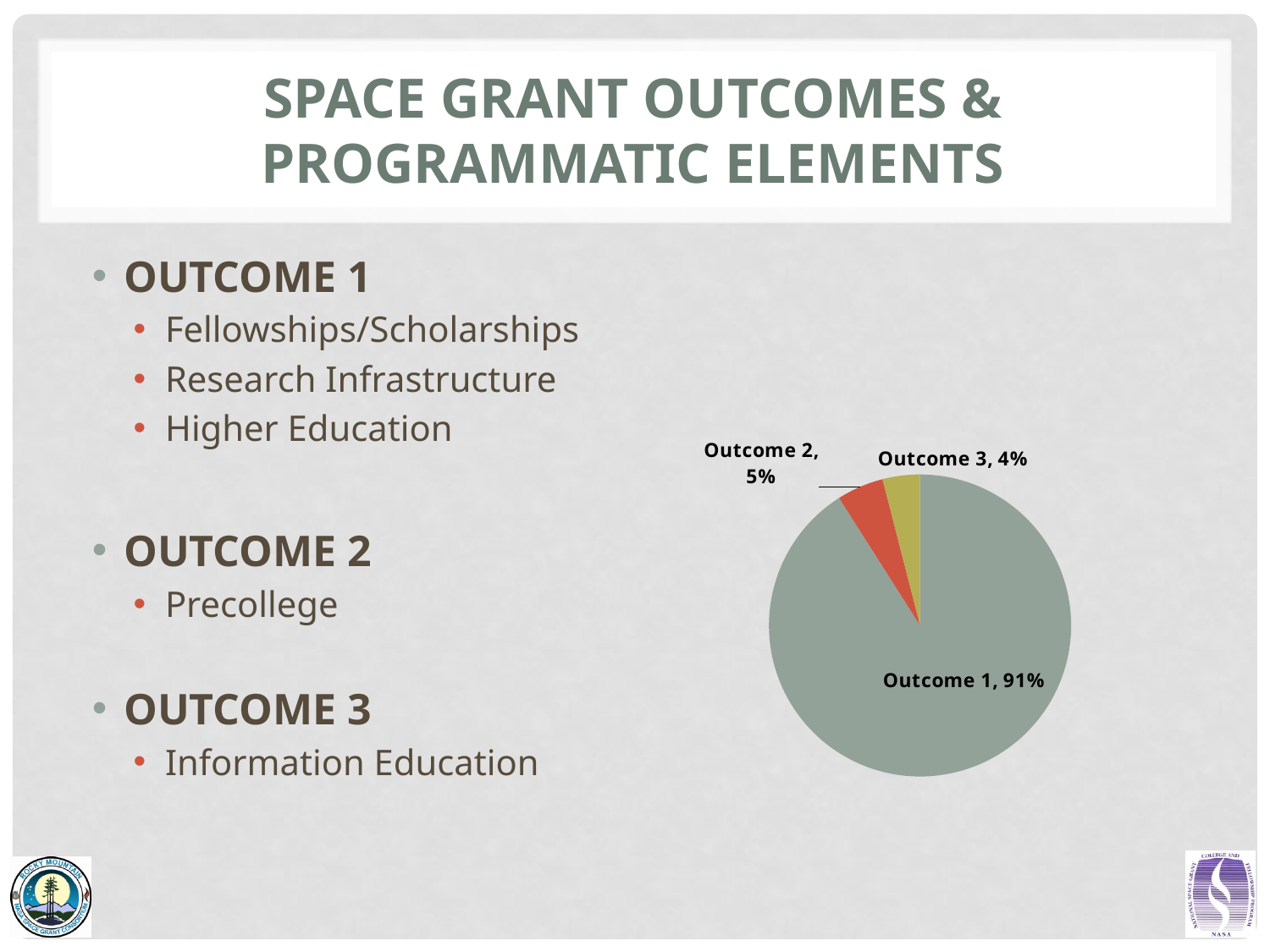
Which is larger, the slice for Outcome 2 or the slice for Outcome 3? Outcome 2 What colour is the slice for Outcome 1? grey-green How many slices does the pie chart have? 3 What is the difference in percentage points between Outcome 2 and Outcome 3? 1 What colour is the slice for Outcome 2? red-orange What is the difference in percentage points between Outcome 1 and Outcome 2? 86 What share of the pie does Outcome 3 represent? 4% Which outcome has the largest slice of the pie? Outcome 1 What kind of chart is shown on the slide? pie chart What share of the pie does Outcome 1 represent? 91% Which outcome has the smallest slice of the pie? Outcome 3 What share of the pie does Outcome 2 represent? 5%